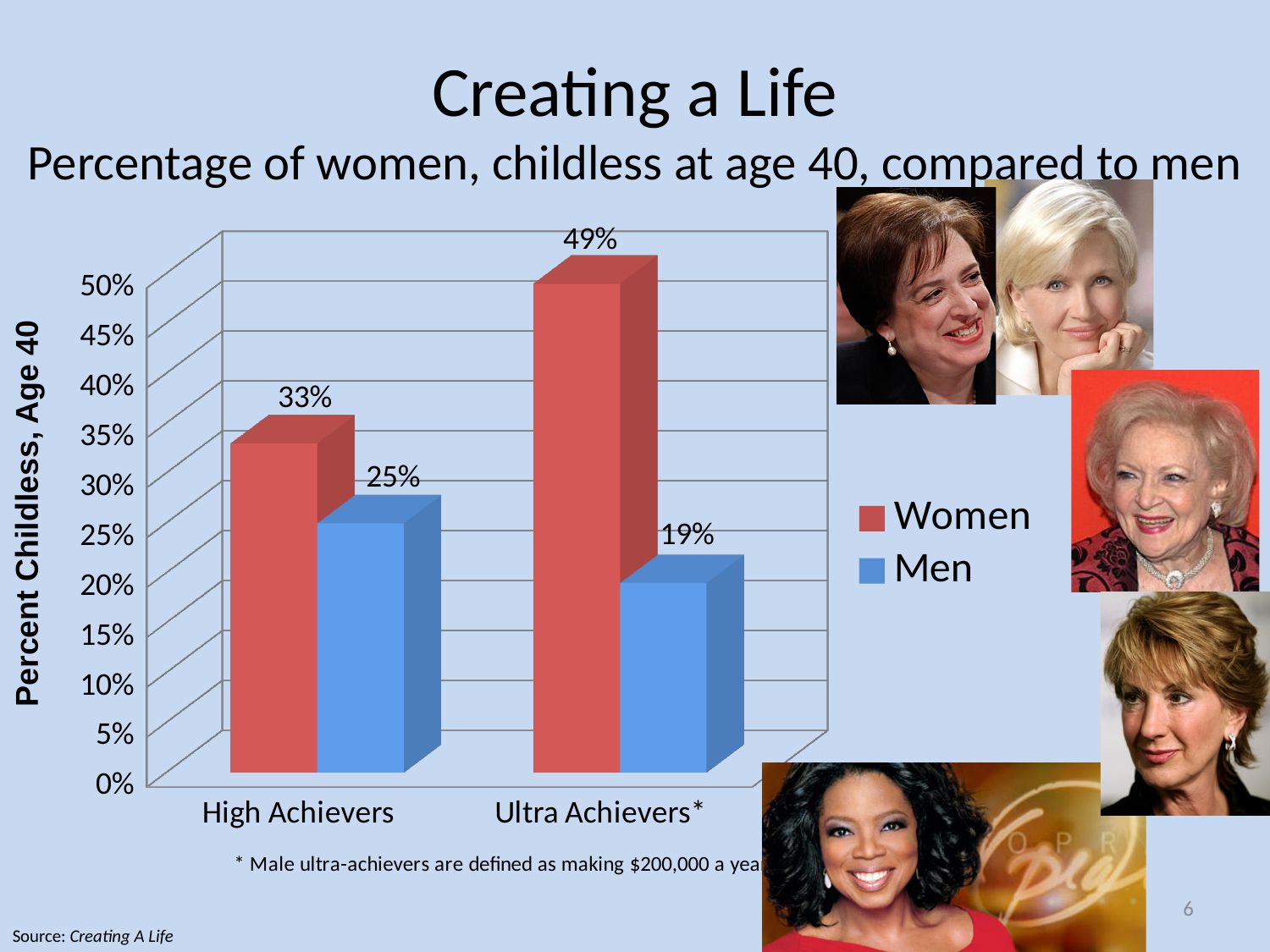
Which bar has the lowest value on the chart? Men, Ultra Achievers What is the value for Men in the High Achievers category? 25% How many series does the legend list? 2 What percentage of men among Ultra Achievers are childless at age 40? 19% How many categories are shown on the x axis? 2 What is the difference between the Women and Men values for High Achievers? 8% What percentage of women among High Achievers are childless at age 40? 33% Which bar has the highest value on the chart? Women, Ultra Achievers What kind of chart is shown on the slide? Bar chart What is the difference between the Women and Men values for Ultra Achievers? 30% Which is larger: the Women value for High Achievers or the Men value for High Achievers? Women What is the value for Women in the Ultra Achievers category? 49%